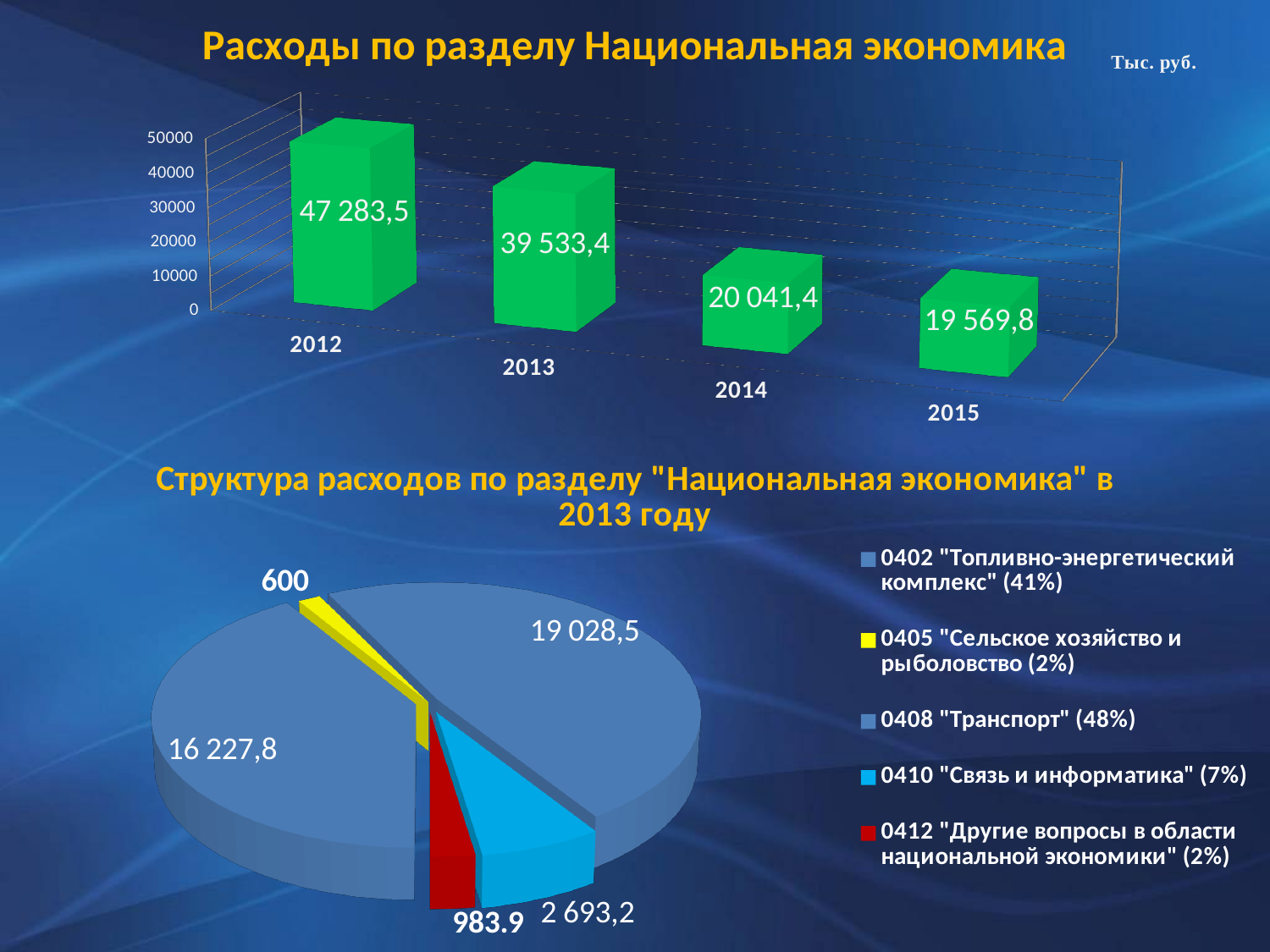
In the bar chart 'Расходы по разделу Национальная экономика', how many years are shown? 4 In the pie chart 'Структура расходов по разделу "Национальная экономика" в 2013 году', what share does 0408 "Транспорт" have? 48% In the bar chart 'Расходы по разделу Национальная экономика', what is the value for 2015? 19 569,8 In the bar chart 'Расходы по разделу Национальная экономика', what is the value for 2012? 47 283,5 In the pie chart 'Структура расходов по разделу "Национальная экономика" в 2013 году', which is larger: the slice for 0410 "Связь и информатика" or the slice for 0412 "Другие вопросы в области национальной экономики"? 0410 "Связь и информатика" How many entries does the legend of the pie chart 'Структура расходов по разделу "Национальная экономика" в 2013 году' list? 5 In the bar chart 'Расходы по разделу Национальная экономика', which year has the highest value? 2012 What kind of chart is the top chart 'Расходы по разделу Национальная экономика'? bar chart In the pie chart 'Структура расходов по разделу "Национальная экономика" в 2013 году', what is the value of the slice for 0405 "Сельское хозяйство и рыболовство"? 600 In the bar chart 'Расходы по разделу Национальная экономика', do the values rise or fall from 2012 to 2015? fall In the bar chart 'Расходы по разделу Национальная экономика', which year has the lowest value? 2015 In the bar chart 'Расходы по разделу Национальная экономика', what is the difference between the values for 2012 and 2013? 7 750,1